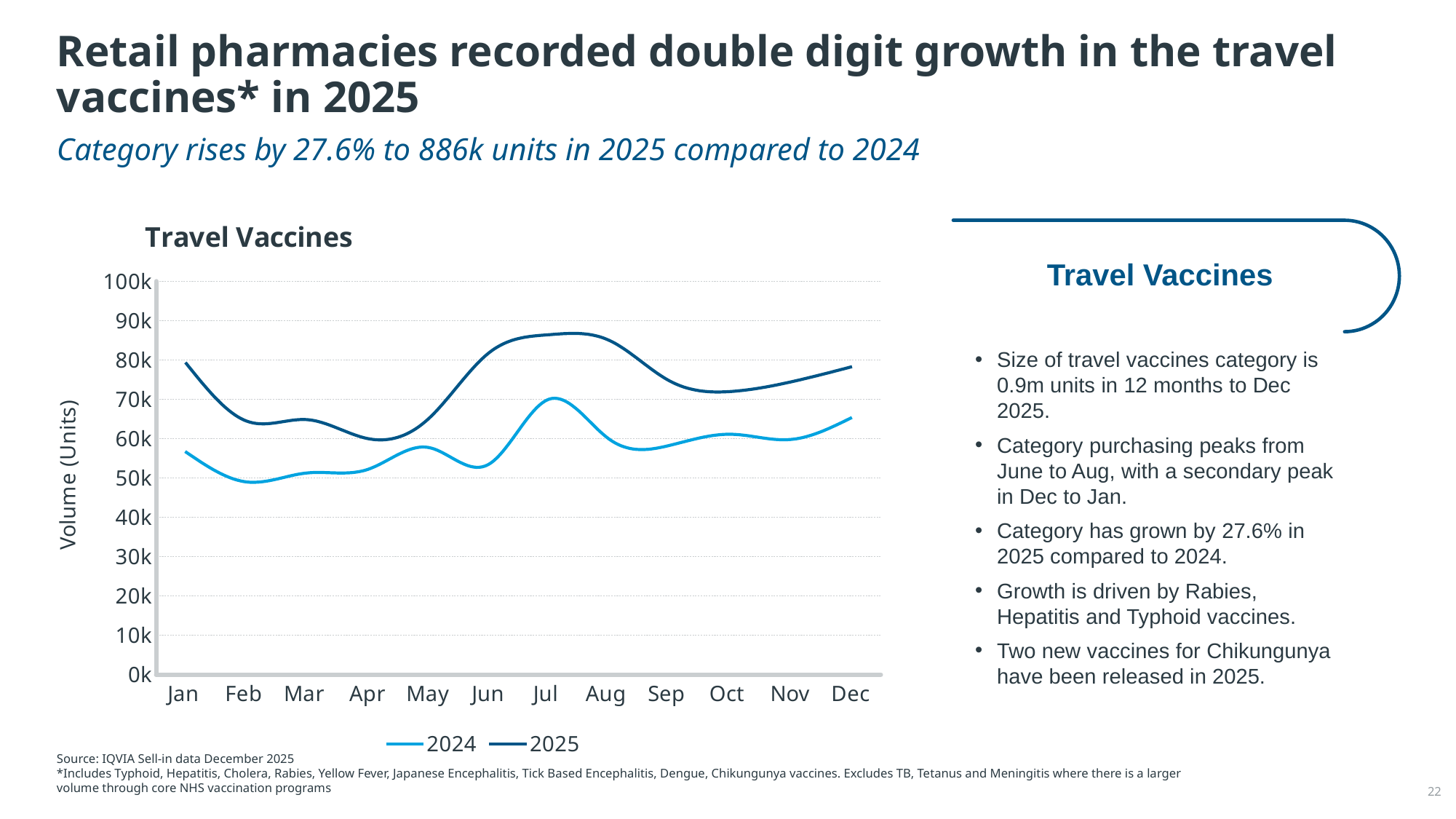
How many months are plotted along the x axis of the chart? 12 In which month does the 2025 series reach its lowest value? Apr Is the value for 2025 in Jan greater or less than 70k? greater What is the label on the vertical axis of the chart? Volume (Units) What kind of chart is shown on the slide? Line chart In which month does the 2024 series reach its lowest value? Feb Which series has the larger value in Jan, 2024 or 2025? 2025 Does the 2025 series rise or fall from Jan to Apr? Fall What is the title of the chart? Travel Vaccines How many series does the chart legend list? 2 Is the value for 2025 in Jul greater or less than 80k? greater In which month does the 2024 series reach its highest value? Jul